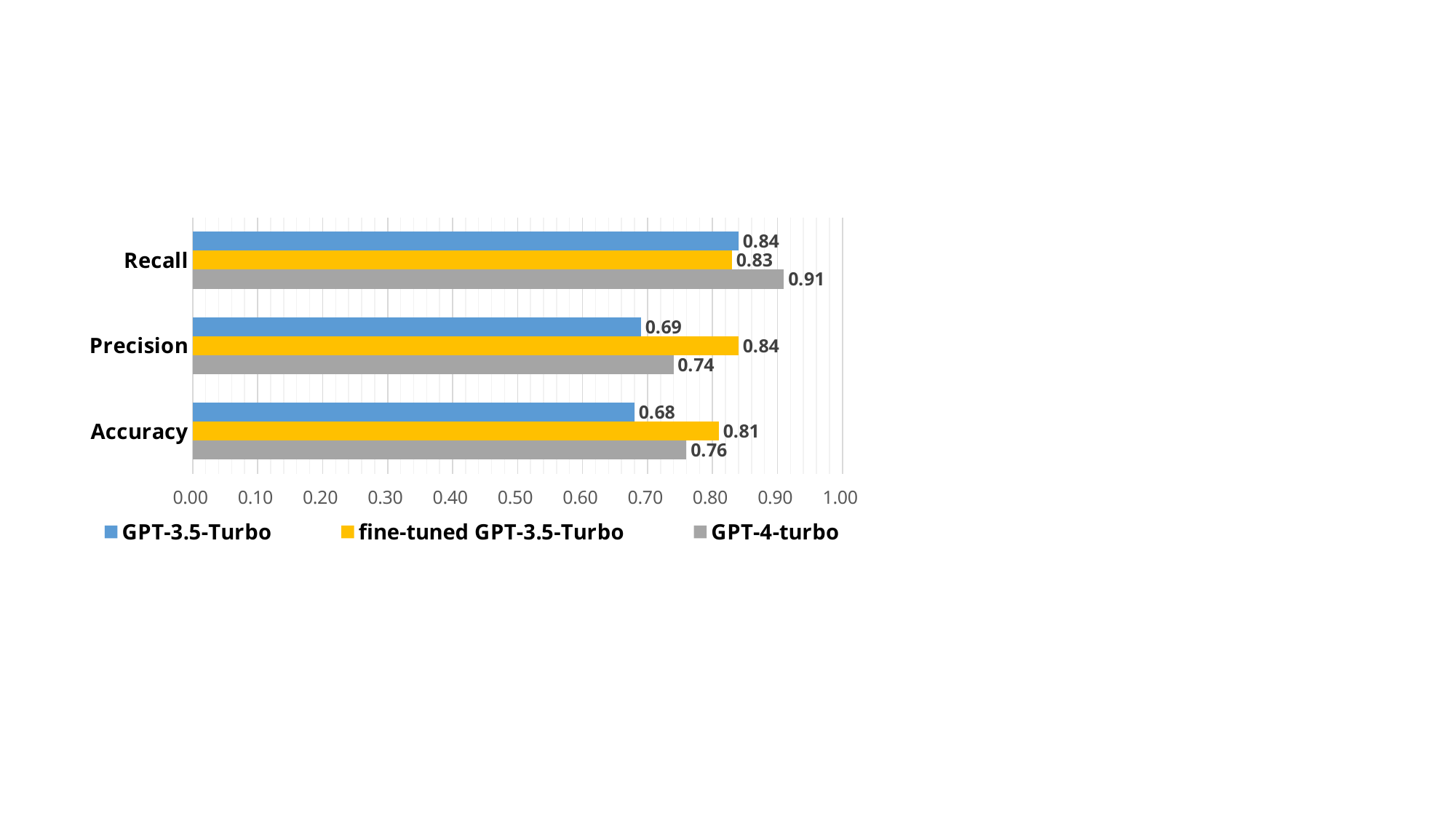
Which colour represents GPT-4-turbo in the chart? grey What is the Recall value for GPT-4-turbo? 0.91 Which model has the lowest Accuracy? GPT-3.5-Turbo What is the difference between the Precision of fine-tuned GPT-3.5-Turbo and GPT-3.5-Turbo? 0.15 How many metric categories are shown on the chart? 3 Which is larger: the Accuracy of fine-tuned GPT-3.5-Turbo or the Accuracy of GPT-4-turbo? fine-tuned GPT-3.5-Turbo Which model has the highest Precision? fine-tuned GPT-3.5-Turbo How many series does the legend list? 3 Is the Recall value for GPT-4-turbo greater or less than 0.90? greater What is the Precision value for fine-tuned GPT-3.5-Turbo? 0.84 What is the Accuracy value for GPT-3.5-Turbo? 0.68 What kind of chart is shown on the slide? bar chart